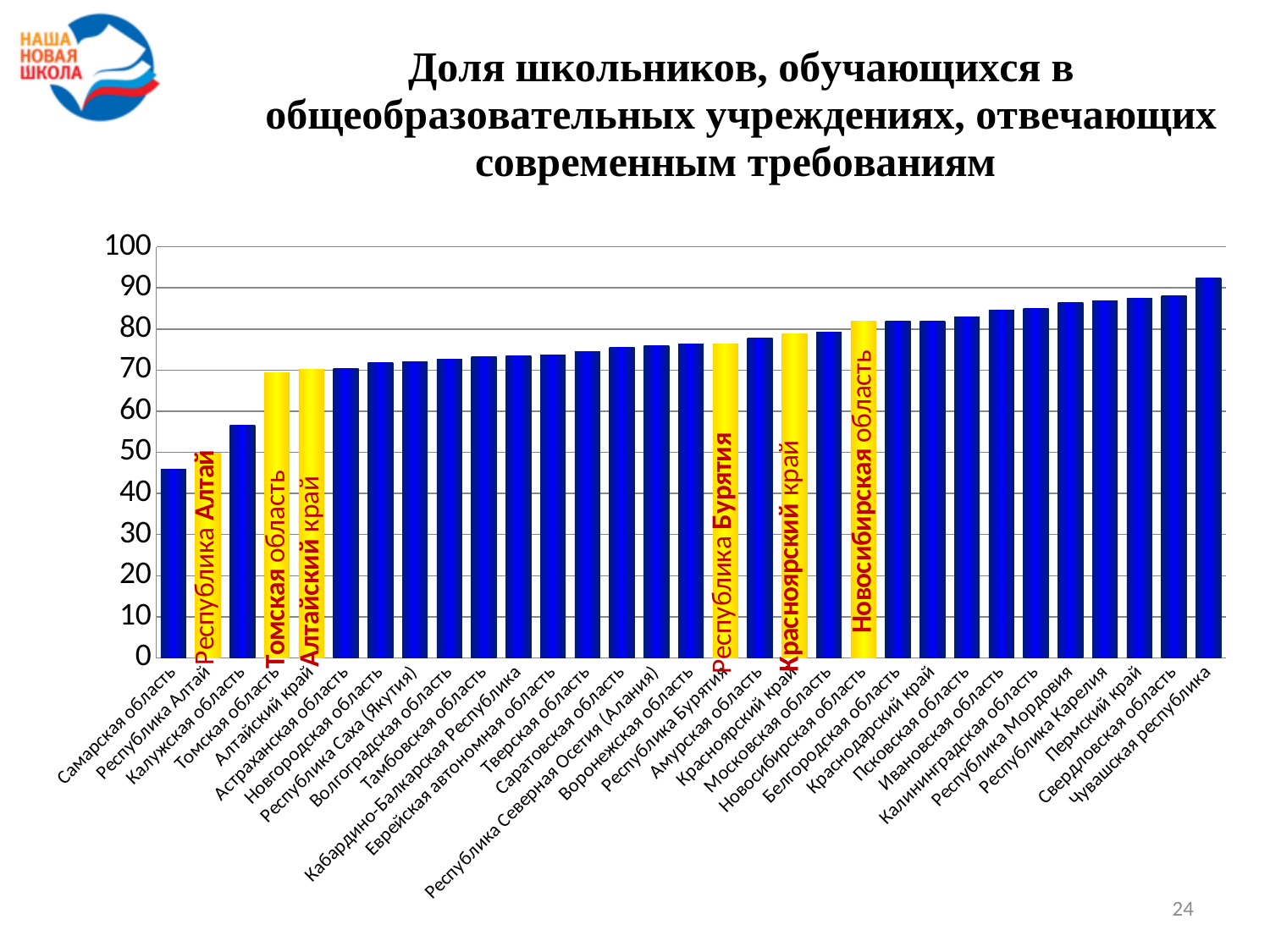
Which is larger, the value for Калужская область or the value for Республика Алтай? Калужская область Is the value for Самарская область greater or less than 50? less What kind of chart is shown on the slide? bar chart Which region has the highest value in the chart? Чувашская республика Is the value for Республика Бурятия greater or less than 70? greater Do the values rise or fall from left to right along the x axis? rise How many regions are shown in the chart? 31 Is the value for Чувашская республика greater or less than 90? greater Which region has the lowest value in the chart? Самарская область How many bars are highlighted in yellow? 6